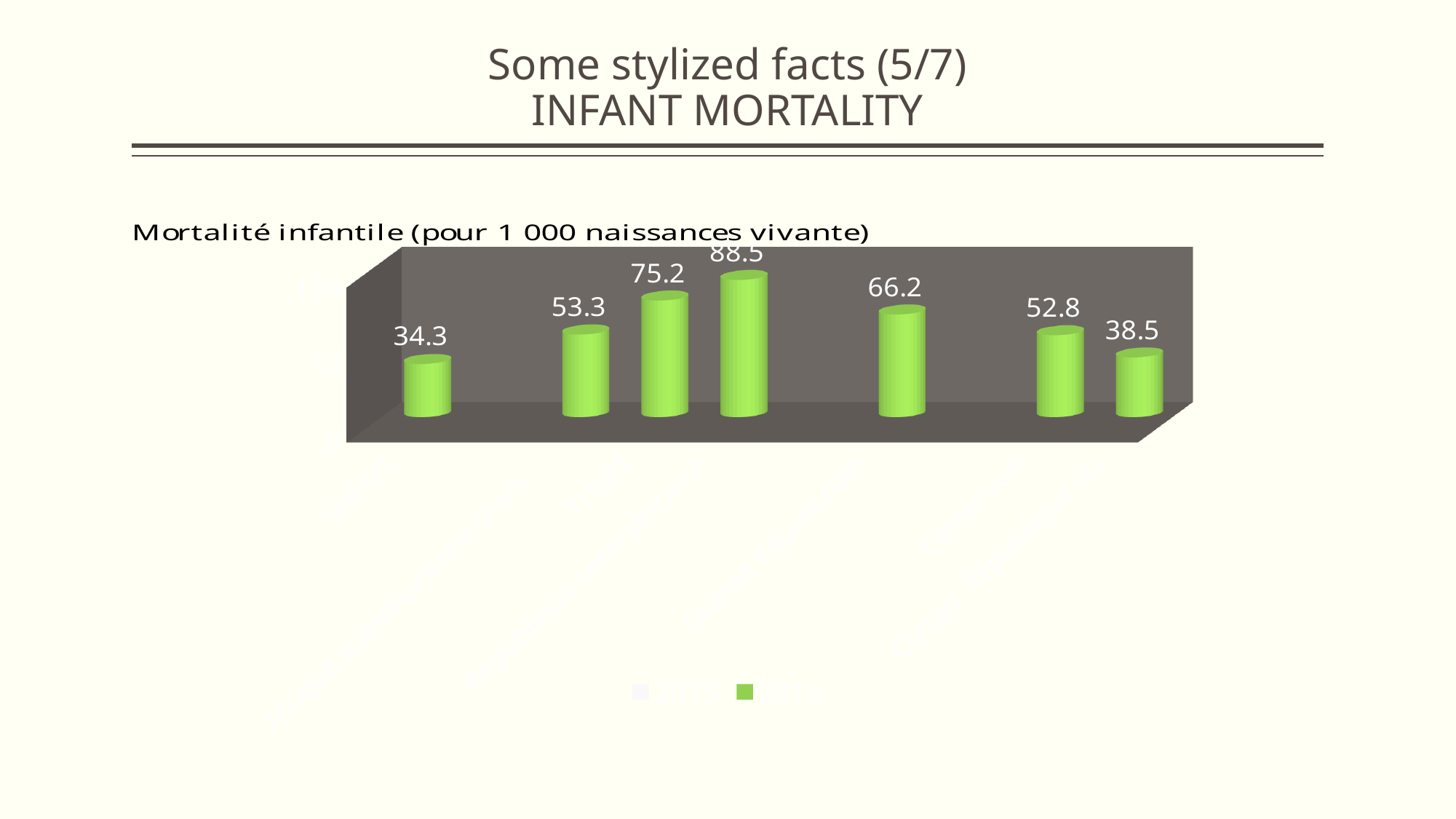
What is the title of the chart on the slide? Mortalité infantile (pour 1 000 naissances vivante) What colour are the bars in the chart? green What is the value shown on the leftmost bar of the chart? 34.3 Which is larger: the value of the fifth bar from the left (66.2) or the sixth bar from the left (52.8)? the fifth bar (66.2) What is the value shown on the third bar from the left? 75.2 How many bars are plotted in the chart? 7 What kind of chart is shown on the slide? bar chart What is the lowest value labelled in the chart? 34.3 What is the difference between the highest labelled value (88.5) and the lowest labelled value (34.3)? 54.2 What is the highest value labelled in the chart? 88.5 What is the value shown on the rightmost bar of the chart? 38.5 What is the value shown on the second bar from the left? 53.3